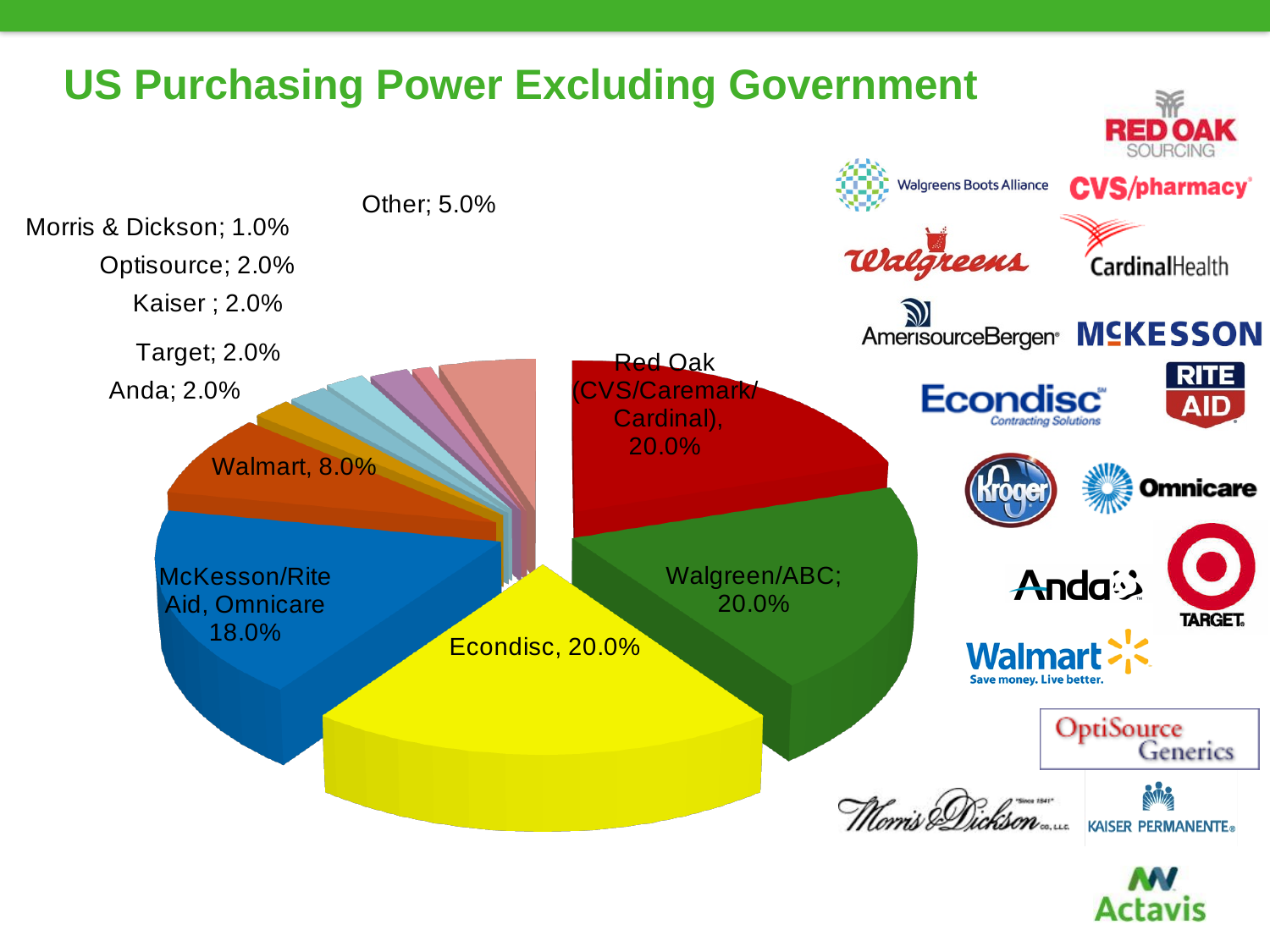
How many slices does the pie chart have? 11 What kind of chart is shown on the slide? pie chart What is the value shown for McKesson/Rite Aid, Omnicare? 18.0% What is the difference between the Walgreen/ABC share and the Walmart share? 12.0% What is the value shown for Econdisc? 20.0% Which slice of the pie is the smallest? Morris & Dickson What is the value shown for Morris & Dickson? 1.0% What is the value shown for Other? 5.0% What share of the pie does Walmart hold? 8.0% What is the title of the chart? US Purchasing Power Excluding Government Which is larger, the share for McKesson/Rite Aid, Omnicare or the share for Red Oak (CVS/Caremark/Cardinal)? Red Oak (CVS/Caremark/Cardinal) What is the difference between the Other share and the Target share? 3.0%